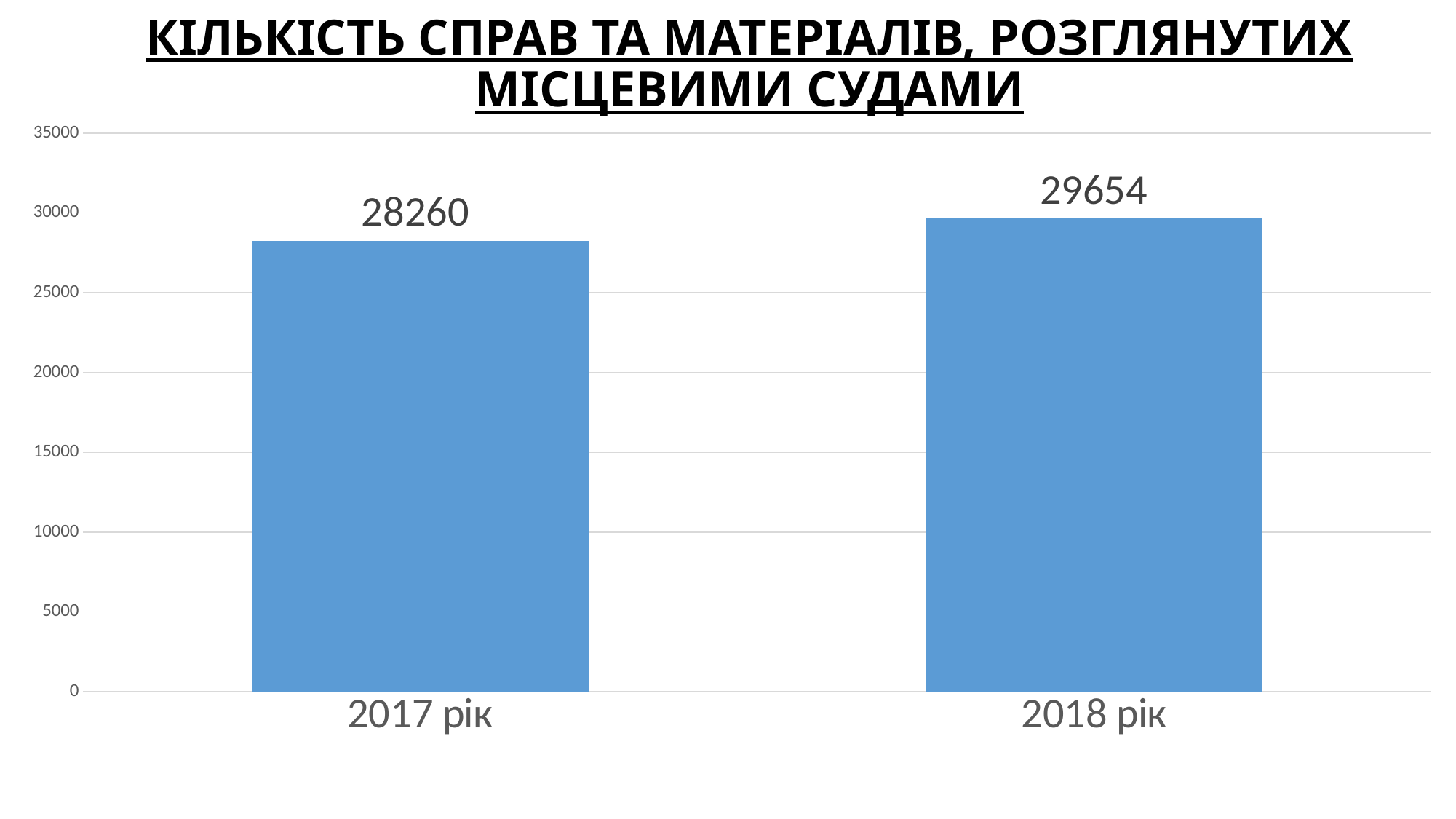
What is the value for 2017 рік? 28260 Is the value for 2018 рік greater or less than 25000? greater What kind of chart is shown on the slide? bar chart How many categories are shown on the chart? 2 Which year has the highest value? 2018 рік What is the value for 2018 рік? 29654 Do the values rise or fall from 2017 рік to 2018 рік? rise Which is larger, the value for 2017 рік or the value for 2018 рік? 2018 рік What is the title of the chart? КІЛЬКІСТЬ СПРАВ ТА МАТЕРІАЛІВ, РОЗГЛЯНУТИХ МІСЦЕВИМИ СУДАМИ Which year has the lowest value? 2017 рік Is the value for 2017 рік greater or less than 30000? less What is the difference between the values for 2018 рік and 2017 рік? 1394